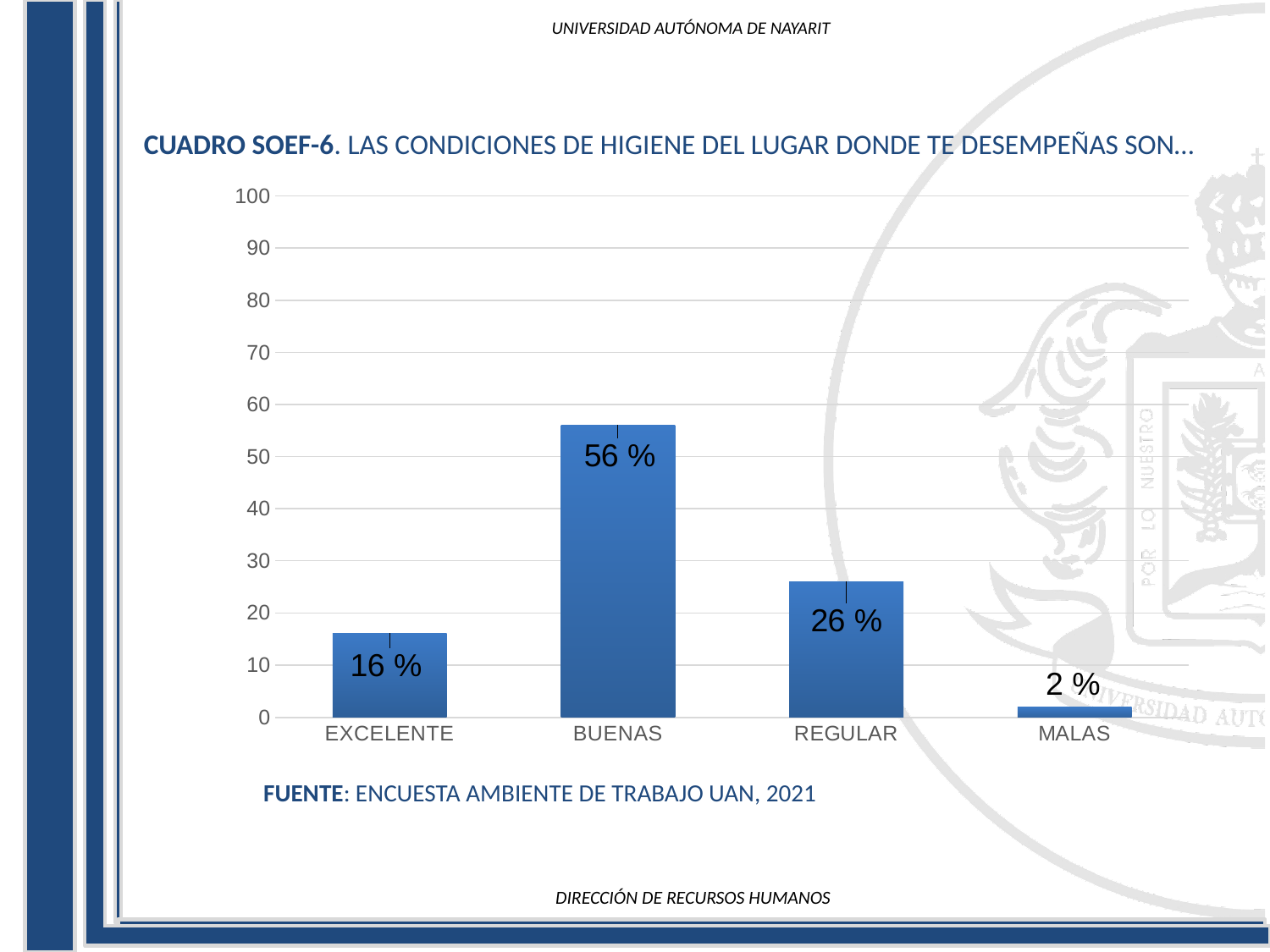
What kind of chart is shown on the slide? bar chart Which is larger, the value for EXCELENTE or the value for REGULAR? REGULAR What source is cited below the chart? ENCUESTA AMBIENTE DE TRABAJO UAN, 2021 Which category has the lowest value? MALAS What is the value for BUENAS? 56 % What is the difference between the values for BUENAS and REGULAR? 30 % Which category has the highest value? BUENAS Is the value for BUENAS greater or less than 50? greater What is the value for EXCELENTE? 16 % What is the difference between the values for REGULAR and MALAS? 24 % What is the value for MALAS? 2 % How many categories are shown on the x axis? 4